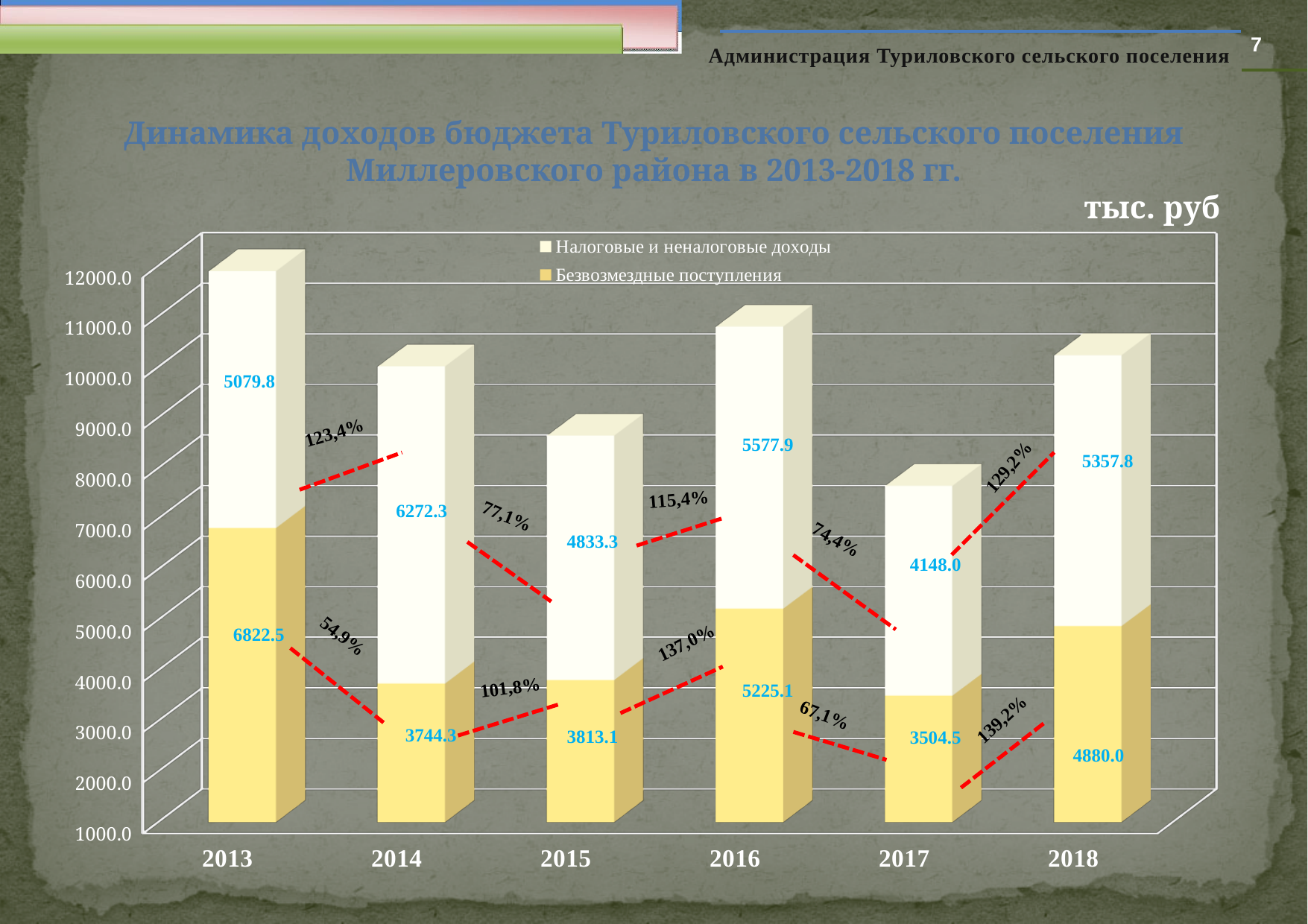
How many years are shown on the x axis? 6 What is the total of the stacked bar for 2017? 7652.5 What unit is stated above the chart? тыс. руб In which year is Безвозмездные поступления the lowest? 2017 What is the value of Безвозмездные поступления in 2013? 6822.5 In which year is Налоговые и неналоговые доходы the highest? 2014 What is the value of Безвозмездные поступления in 2018? 4880.0 Which is larger in 2015: Налоговые и неналоговые доходы or Безвозмездные поступления? Налоговые и неналоговые доходы How many series does the legend list? 2 What type of chart is shown on the slide? bar chart What is the difference between Налоговые и неналоговые доходы in 2016 and in 2017? 1429.9 What is the value of Налоговые и неналоговые доходы in 2014? 6272.3